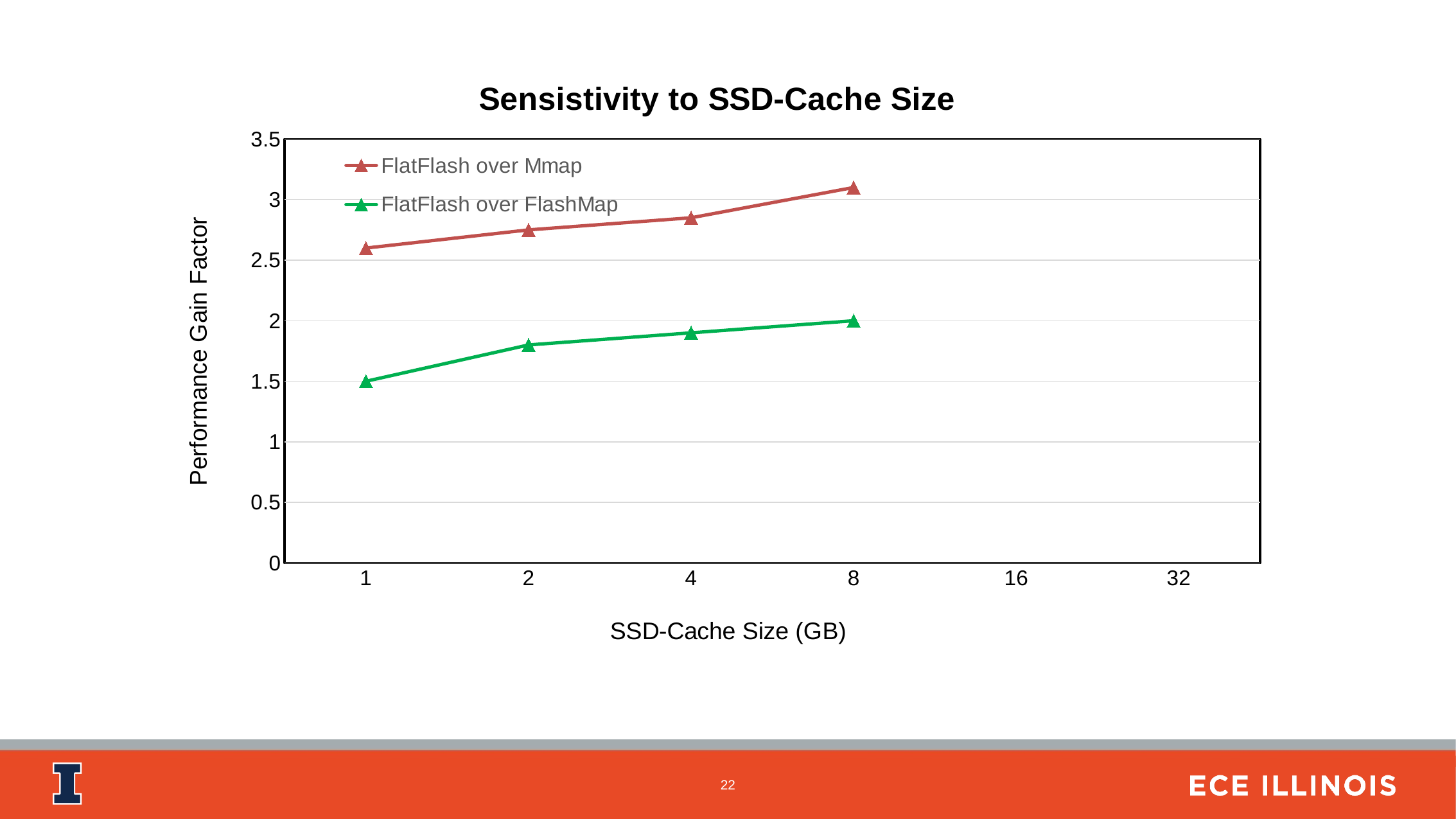
Does the Performance Gain Factor for FlatFlash over Mmap rise or fall as the SSD-cache size increases? rise What is the Performance Gain Factor for FlatFlash over FlashMap at an SSD-cache size of 1 GB? 1.5 What kind of chart is shown on the slide? line chart Is the value for FlatFlash over FlashMap at 4 GB greater or less than 2? less What is the title of the chart? Sensistivity to SSD-Cache Size Is the value for FlatFlash over Mmap at 8 GB greater or less than 3? greater Which series has the higher Performance Gain Factor at an SSD-cache size of 4 GB, FlatFlash over Mmap or FlatFlash over FlashMap? FlatFlash over Mmap Is the value for FlatFlash over Mmap at 1 GB greater or less than 2.5? greater What is the label of the y axis? Performance Gain Factor How many series does the legend list? 2 How many SSD-cache sizes have plotted data points for each series? 4 What is the Performance Gain Factor for FlatFlash over FlashMap at an SSD-cache size of 8 GB? 2